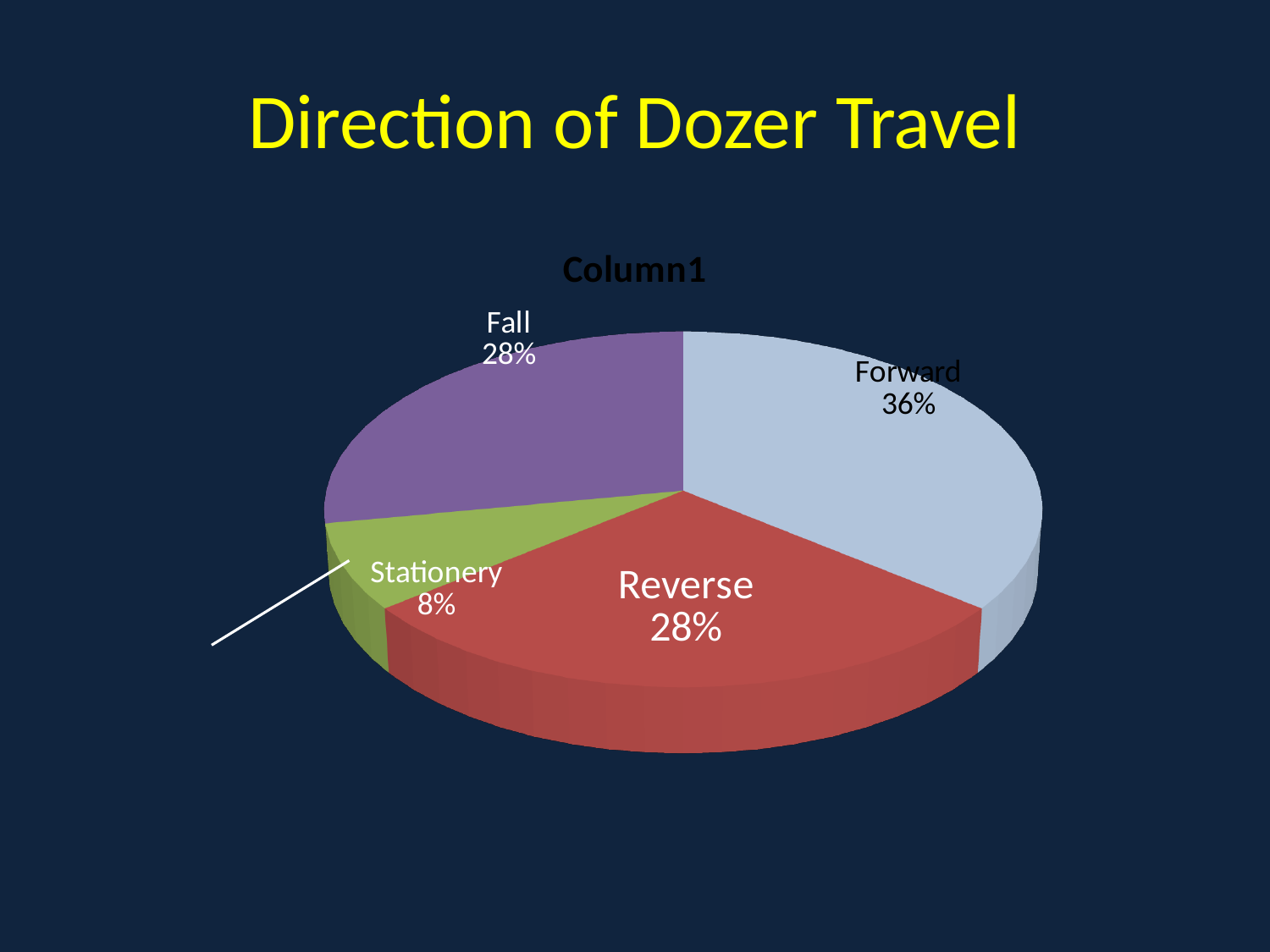
What is the title of the slide? Direction of Dozer Travel What kind of chart is shown on the slide? Pie chart What is the difference in percentage points between the Forward and Reverse slices? 8 Which slice is larger, Forward or Reverse? Forward What percentage is shown for the Reverse slice? 28% Which category has the smallest share of the pie? Stationery What percentage is shown for the Fall slice? 28% What percentage is shown for the Stationery slice? 8% What percentage of the pie does the Forward slice represent? 36% Which category has the largest share of the pie? Forward How many slices does the pie chart have? 4 What is the difference in percentage points between the Forward and Stationery slices? 28